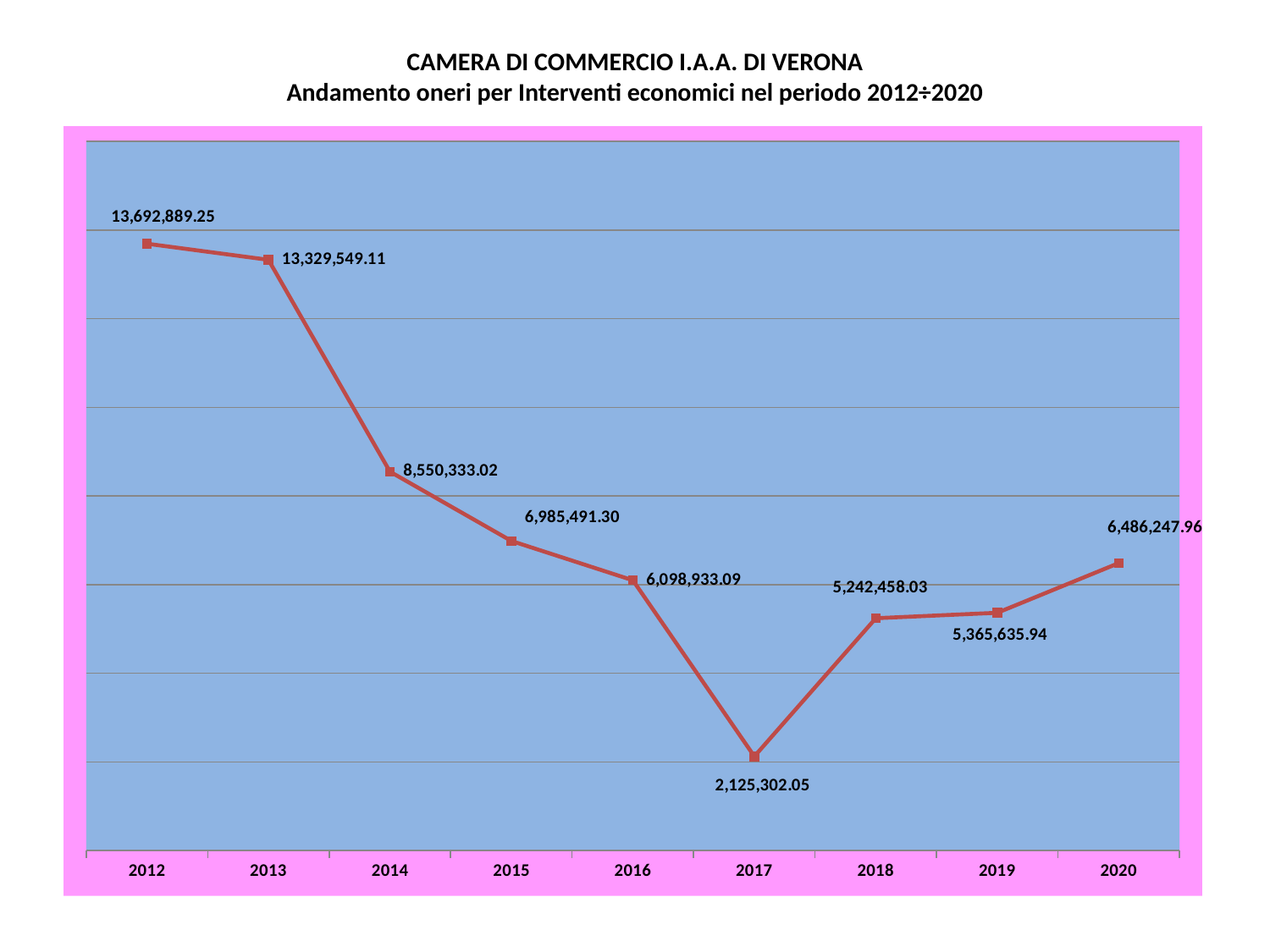
Which year has the highest value? 2012 What is the value for 2017? 2,125,302.05 Which year has the lowest value? 2017 What is the value for 2012? 13,692,889.25 What is the value for 2015? 6,985,491.30 Which is larger, the value for 2014 or the value for 2016? 2014 Do the values rise or fall from 2012 to 2017? fall What is the value for 2020? 6,486,247.96 What kind of chart is shown? line chart What is the difference between the values for 2020 and 2019? 1,120,612.02 How many years are plotted on the chart? 9 What is the difference between the values for 2012 and 2013? 363,340.14